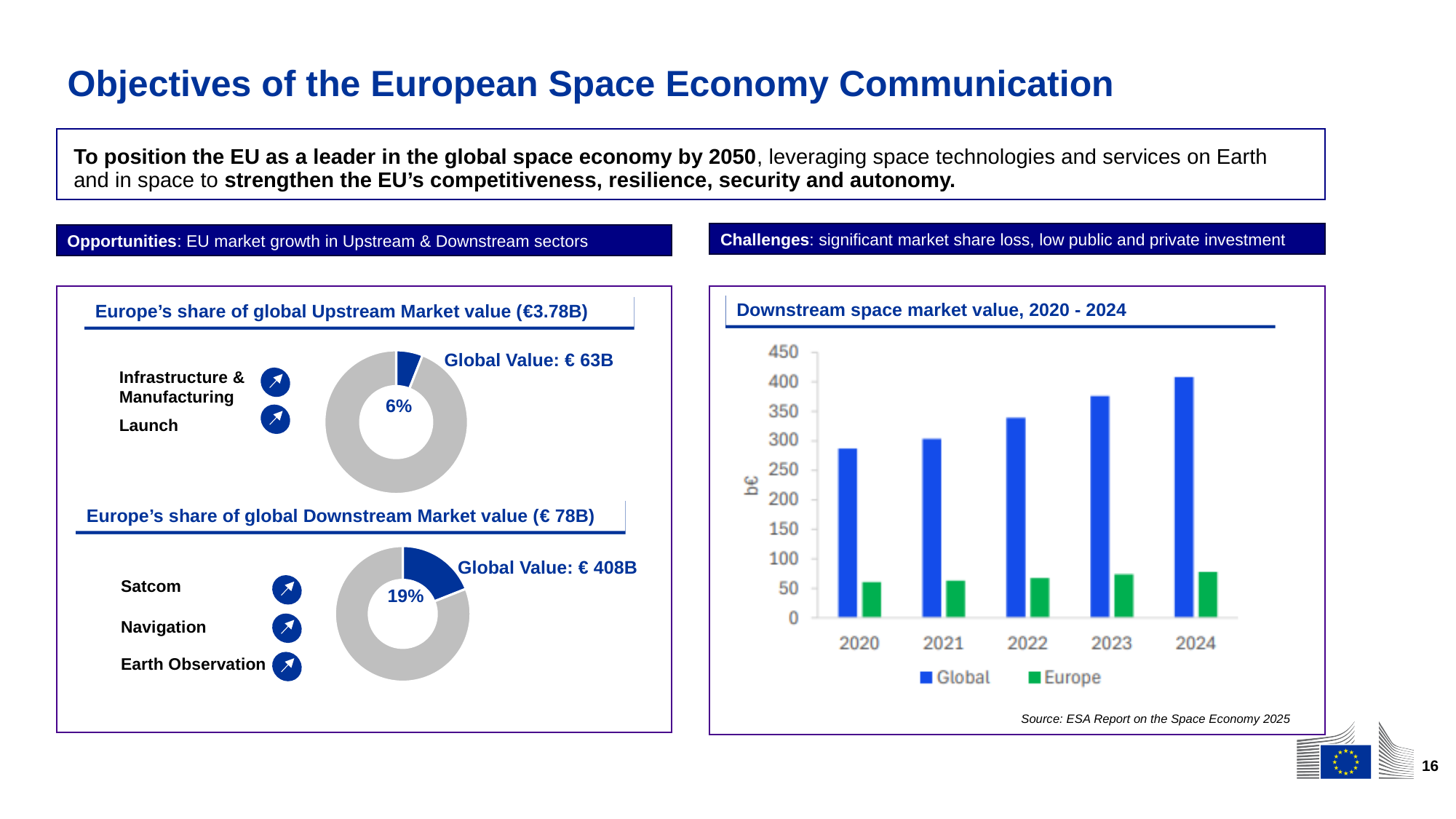
In the 'Europe's share of global Downstream Market value' chart, what is the global value shown? € 408B In the 'Downstream space market value, 2020 - 2024' chart, is the Global value for 2020 greater or less than 300? less In the 'Downstream space market value, 2020 - 2024' chart, how many years are shown on the x axis? 5 In the 'Downstream space market value, 2020 - 2024' chart, do the Global values rise or fall from 2020 to 2024? Rise In the 'Europe's share of global Upstream Market value' chart, what is the global value shown? € 63B In the 'Downstream space market value, 2020 - 2024' chart, how many series does the legend list? 2 In the 'Europe's share of global Downstream Market value' donut chart, what percentage share does Europe hold? 19% In the 'Downstream space market value, 2020 - 2024' chart, in which year is the Global value lowest? 2020 In the 'Downstream space market value, 2020 - 2024' chart, is the Europe value for 2024 greater or less than 100? less In the 'Downstream space market value, 2020 - 2024' chart, what kind of chart is used? Bar chart In the 'Europe's share of global Upstream Market value' donut chart, what percentage share does Europe hold? 6% In the 'Downstream space market value, 2020 - 2024' chart, in which year is the Global value highest? 2024